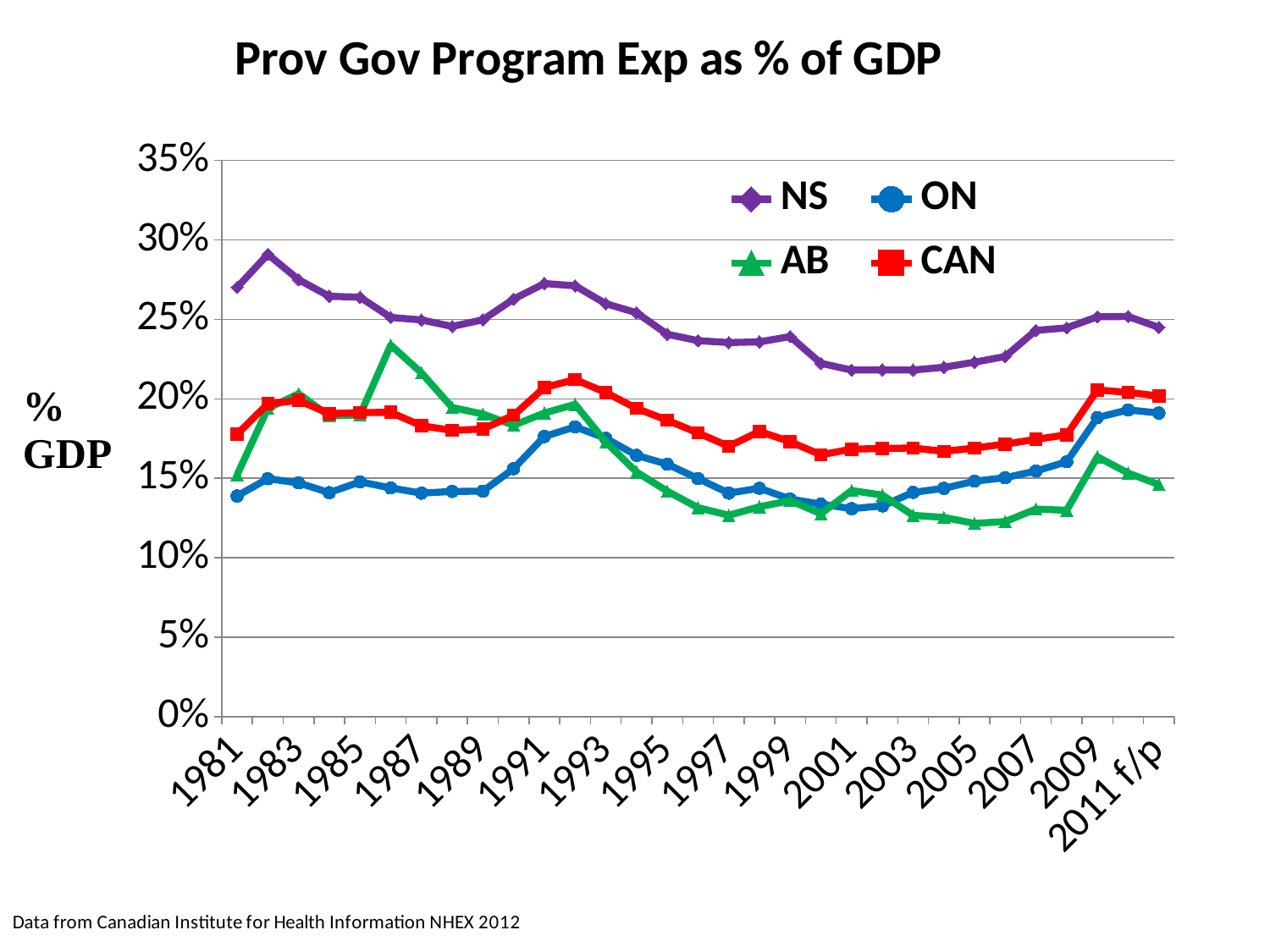
Is the value for CAN in 2001 greater or less than 20%? less Is the value for NS in 1981 greater or less than 25%? greater What is the title of the chart? Prov Gov Program Exp as % of GDP What is the label on the vertical axis? % GDP Does the ON series rise or fall from 2001 to 2011 f/p? rise In 1987, which is larger, the value for AB or the value for CAN? AB Which series has the highest values across the whole period? NS In 2005, which is larger, the value for ON or the value for AB? ON Which series has the lowest value in 2005? AB What kind of chart is shown on the slide? line chart How many series does the legend list? 4 Is the value for AB in 1987 greater or less than 20%? greater